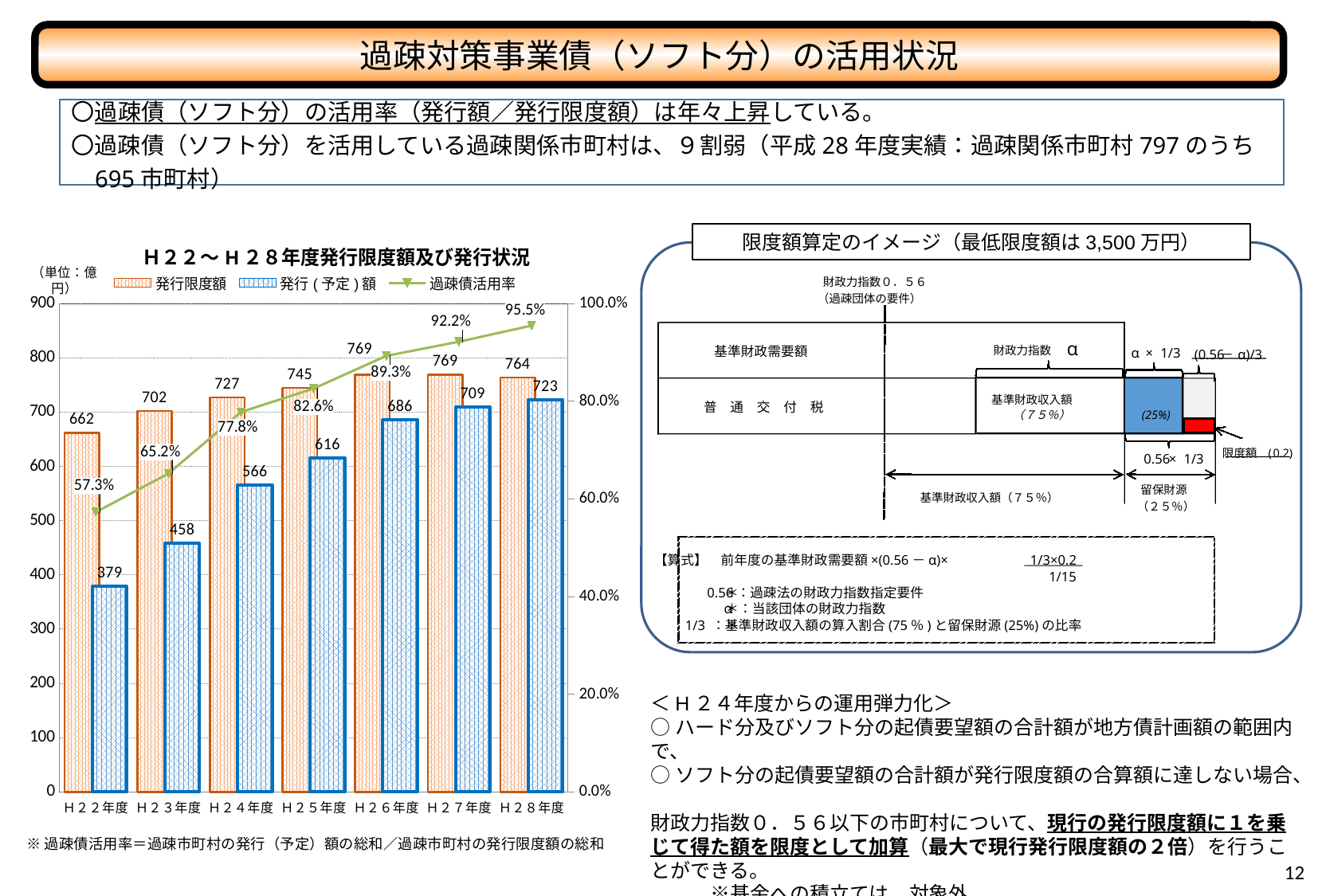
What is the difference between the 発行限度額 and the 発行（予定）額 for Ｈ２３年度? 244 Does the 過疎債活用率 rise or fall from Ｈ２２年度 to Ｈ２８年度? rise How many series does the chart legend list? 3 Is the 発行（予定）額 for Ｈ２６年度 greater or less than 600? greater What kind of chart is used to show the 発行限度額 and 発行（予定）額 values? bar chart What is the 過疎債活用率 for Ｈ２５年度? 82.6% Which is larger for Ｈ２４年度: the 発行限度額 or the 発行（予定）額? 発行限度額 What is the 発行限度額 value for Ｈ２２年度? 662 Which year has the highest 過疎債活用率? Ｈ２８年度 Which year has the lowest 発行（予定）額? Ｈ２２年度 How many fiscal years are shown on the x axis of the chart? 7 What is the 発行（予定）額 value for Ｈ２８年度? 723